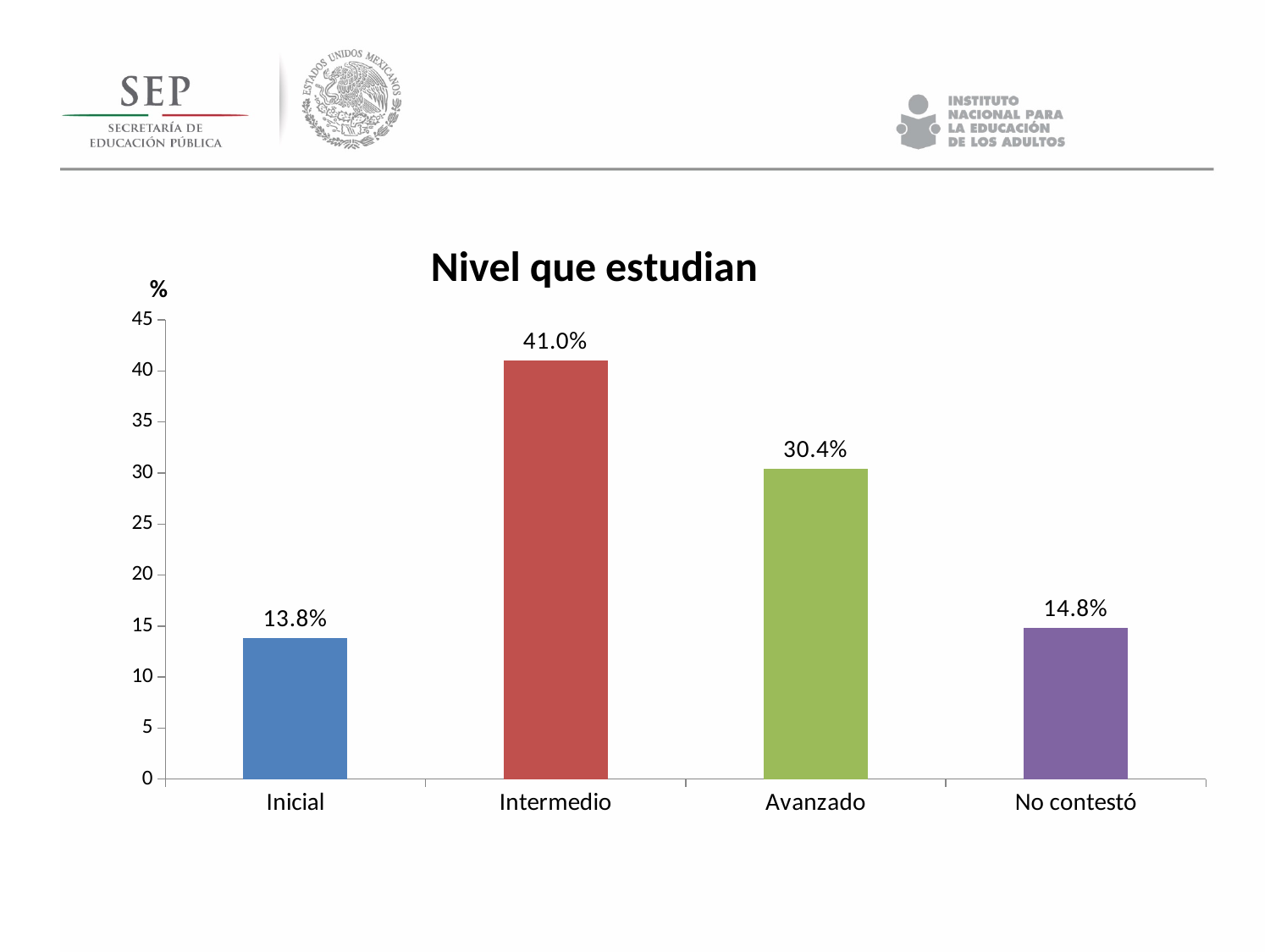
How many categories are shown on the x axis? 4 What is the value for No contestó? 14.8% What is the difference between the values for Intermedio and Avanzado? 10.6% Which is larger, the value for Avanzado or the value for No contestó? Avanzado What is the title of the chart? Nivel que estudian What is the value for Intermedio? 41.0% Which category has the lowest value? Inicial What kind of chart is this? Bar chart What is the difference between the values for No contestó and Inicial? 1.0% What is the value for Avanzado? 30.4% What is the value for Inicial? 13.8% Which category has the highest value? Intermedio